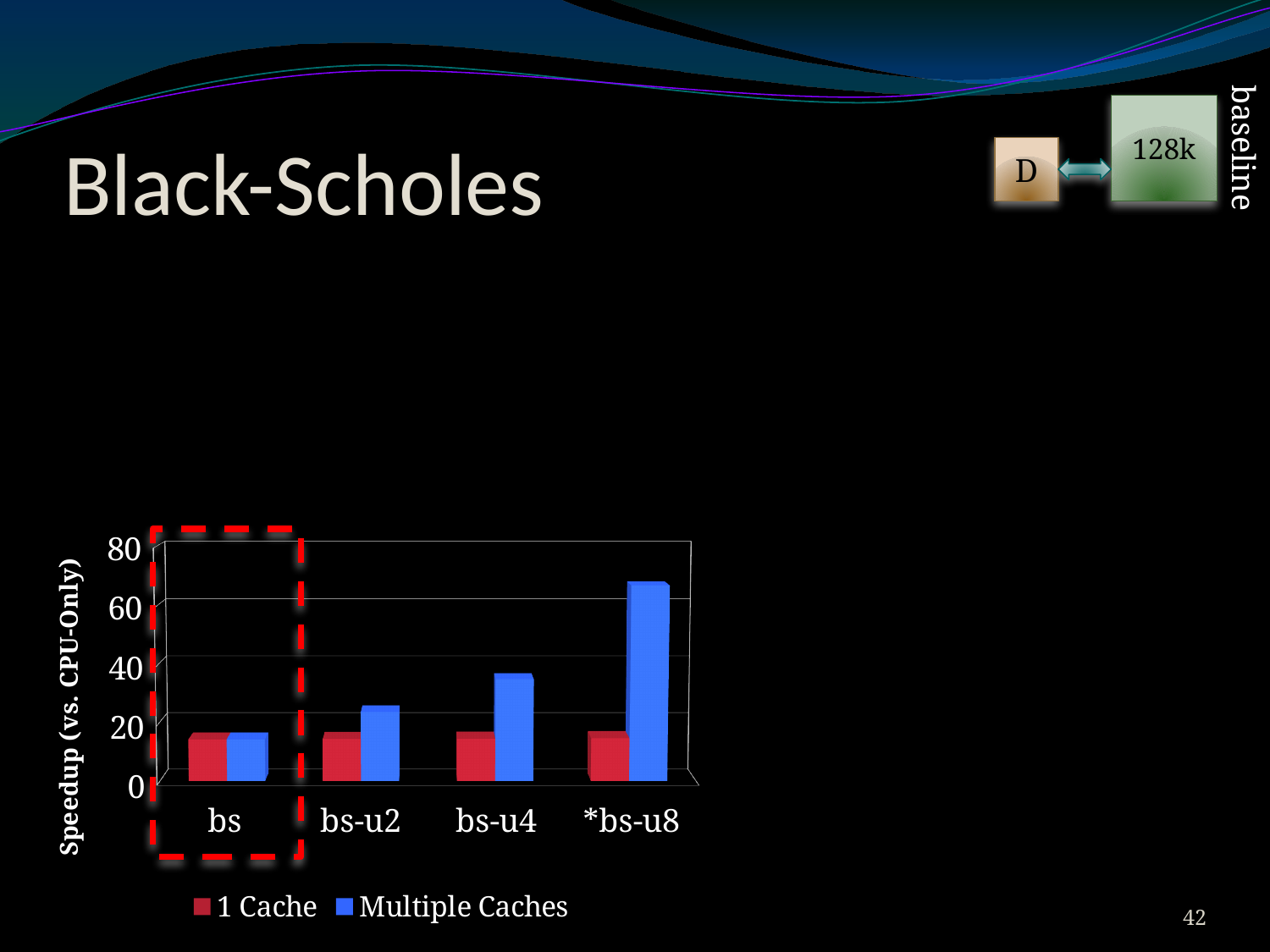
Is the 1 Cache value for bs-u2 greater or less than 20? less Is the Multiple Caches value for bs-u2 greater or less than 20? greater Is the Multiple Caches value for bs-u4 greater or less than 40? less How many categories are shown on the x axis of the chart? 4 How many series does the chart's legend list? 2 Do the Multiple Caches values rise or fall from bs to *bs-u8? rise Which series is shown in blue in the chart's legend? Multiple Caches Which category has the highest Multiple Caches value? *bs-u8 What kind of chart is shown on the slide? bar chart What is the title of the chart's vertical axis? Speedup (vs. CPU-Only) For bs-u4, which series has the larger value: 1 Cache or Multiple Caches? Multiple Caches